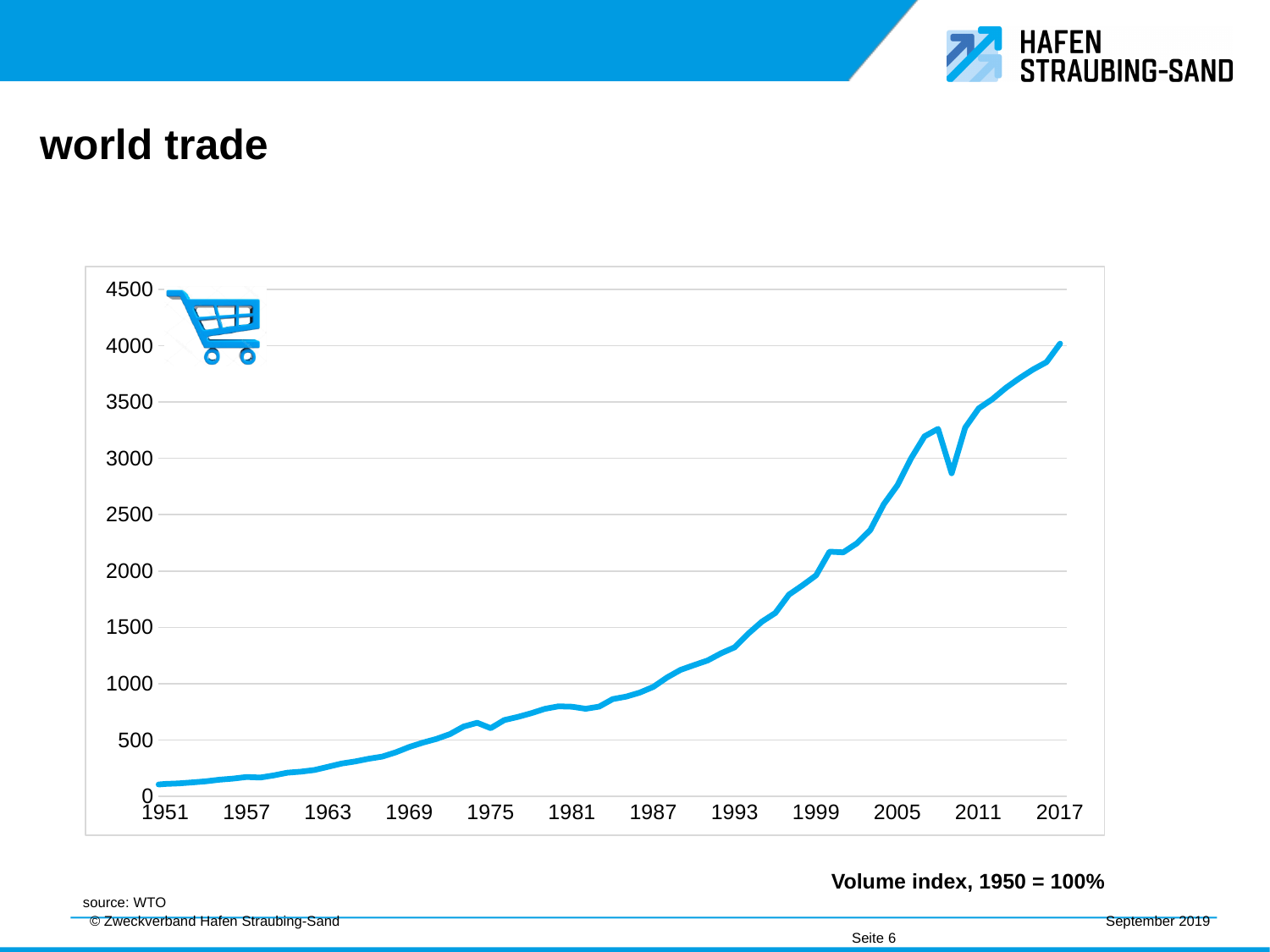
Is the value for 1981 greater or less than 1000? less What is the title of the slide's chart? world trade Is the value for 1993 greater or less than 1500? less Is the value for 1951 greater or less than 500? less Which year on the x axis has the highest value in the world trade chart? 2017 Which year has the larger value, 1969 or 1999? 1999 What kind of chart is shown on the slide? line chart Which year on the x axis has the lowest value in the world trade chart? 1951 How many year labels are shown on the x axis of the chart? 12 Do the values in the world trade chart generally rise or fall from 1951 to 2017? rise